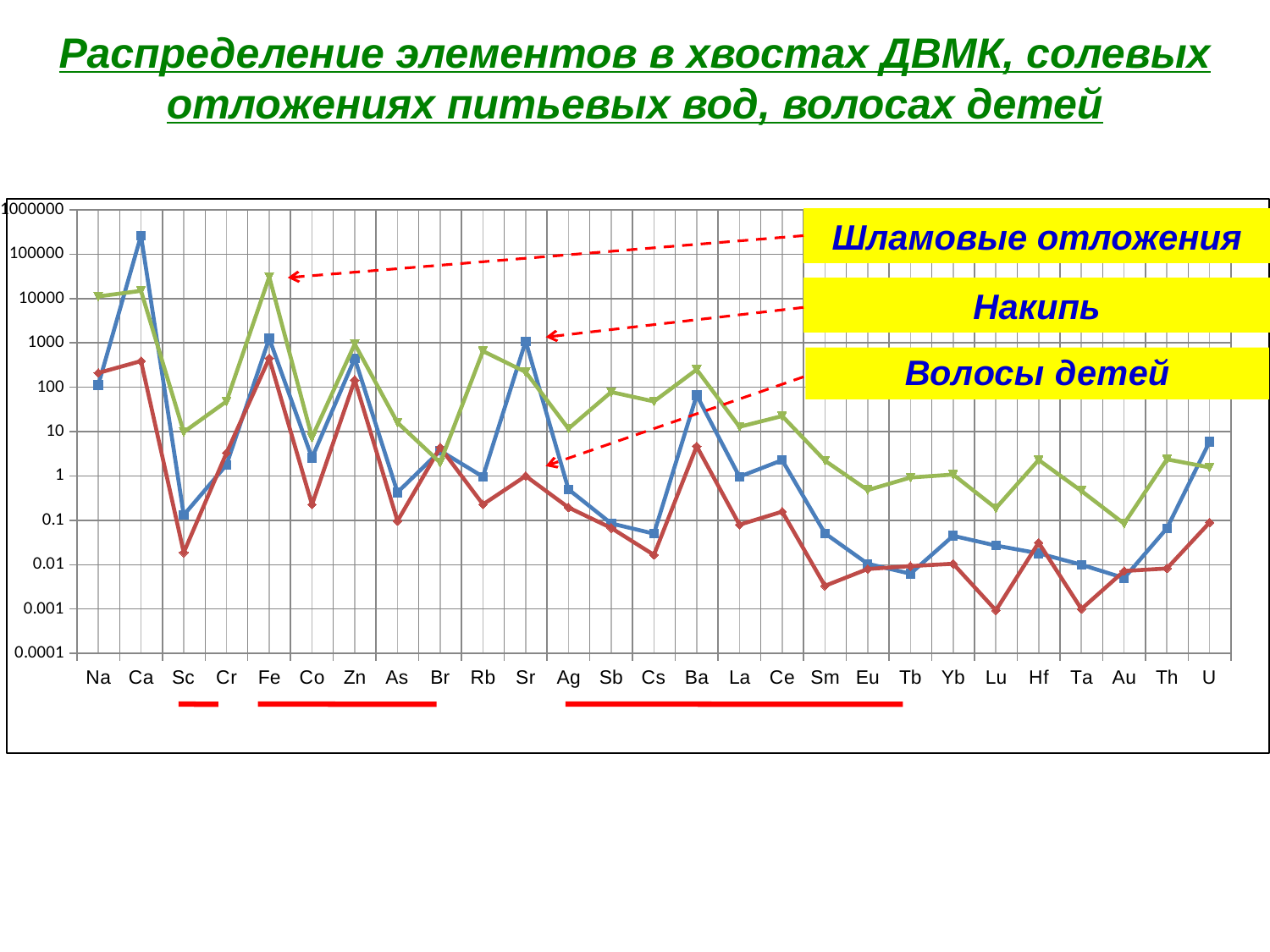
Is the value of the Накипь series for Ca greater or less than 100000? greater Which series is labelled in the top yellow box on the chart? Шламовые отложения Is the value of the Накипь series for Sr greater or less than 100? greater Is the value of the Шламовые отложения series for Fe greater or less than 10000? greater For which element does the Накипь series reach its highest value? Ca How many elements are listed along the x axis of the chart? 27 For which element does the Шламовые отложения series reach its highest value? Fe At Ca, which series has the higher value: Накипь or Шламовые отложения? Накипь What kind of chart is shown on the slide? line chart How many data series are labelled on the chart? 3 For which element does the Шламовые отложения series reach its lowest value? Au